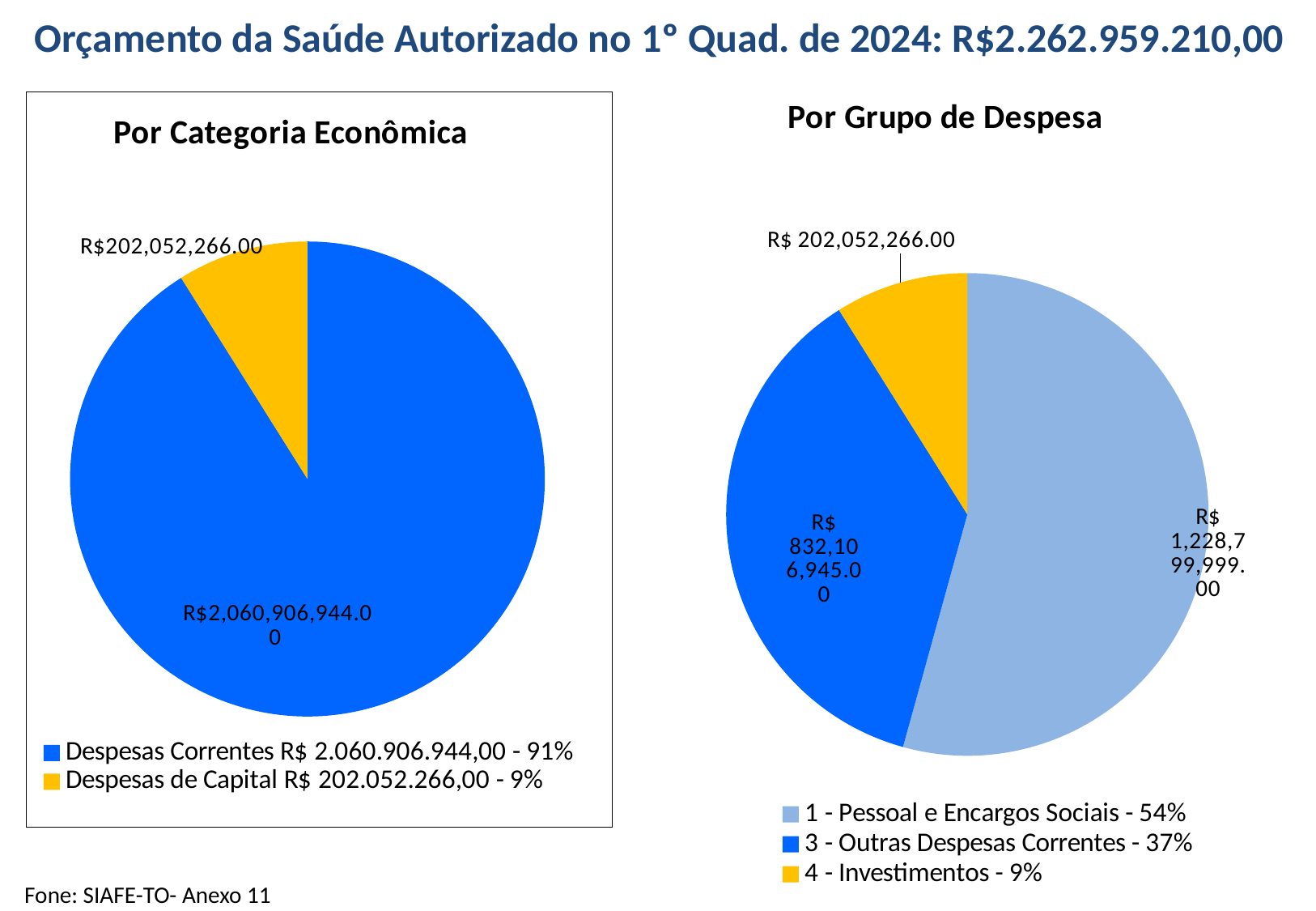
In the 'Por Grupo de Despesa' chart, what colour is the 4 - Investimentos slice? yellow In the 'Por Categoria Econômica' chart, what is the difference between Despesas Correntes and Despesas de Capital? R$1,858,854,678.00 In the 'Por Grupo de Despesa' chart, what is the value for 1 - Pessoal e Encargos Sociais? R$ 1,228,799,999.00 How many slices does the 'Por Grupo de Despesa' chart have? 3 In the 'Por Categoria Econômica' chart, what is the value for Despesas de Capital? R$202,052,266.00 In the 'Por Grupo de Despesa' chart, what is the value for 3 - Outras Despesas Correntes? R$ 832,106,945.00 In the 'Por Grupo de Despesa' chart, what share of the pie is 3 - Outras Despesas Correntes? 37% In the 'Por Categoria Econômica' chart, what share of the pie is Despesas de Capital? 9% What type of chart is the 'Por Categoria Econômica' chart? pie chart In the 'Por Categoria Econômica' chart, what is the value for Despesas Correntes? R$2,060,906,944.00 In the 'Por Grupo de Despesa' chart, which is larger: 1 - Pessoal e Encargos Sociais or 3 - Outras Despesas Correntes? 1 - Pessoal e Encargos Sociais In the 'Por Grupo de Despesa' chart, which group has the smallest slice? 4 - Investimentos